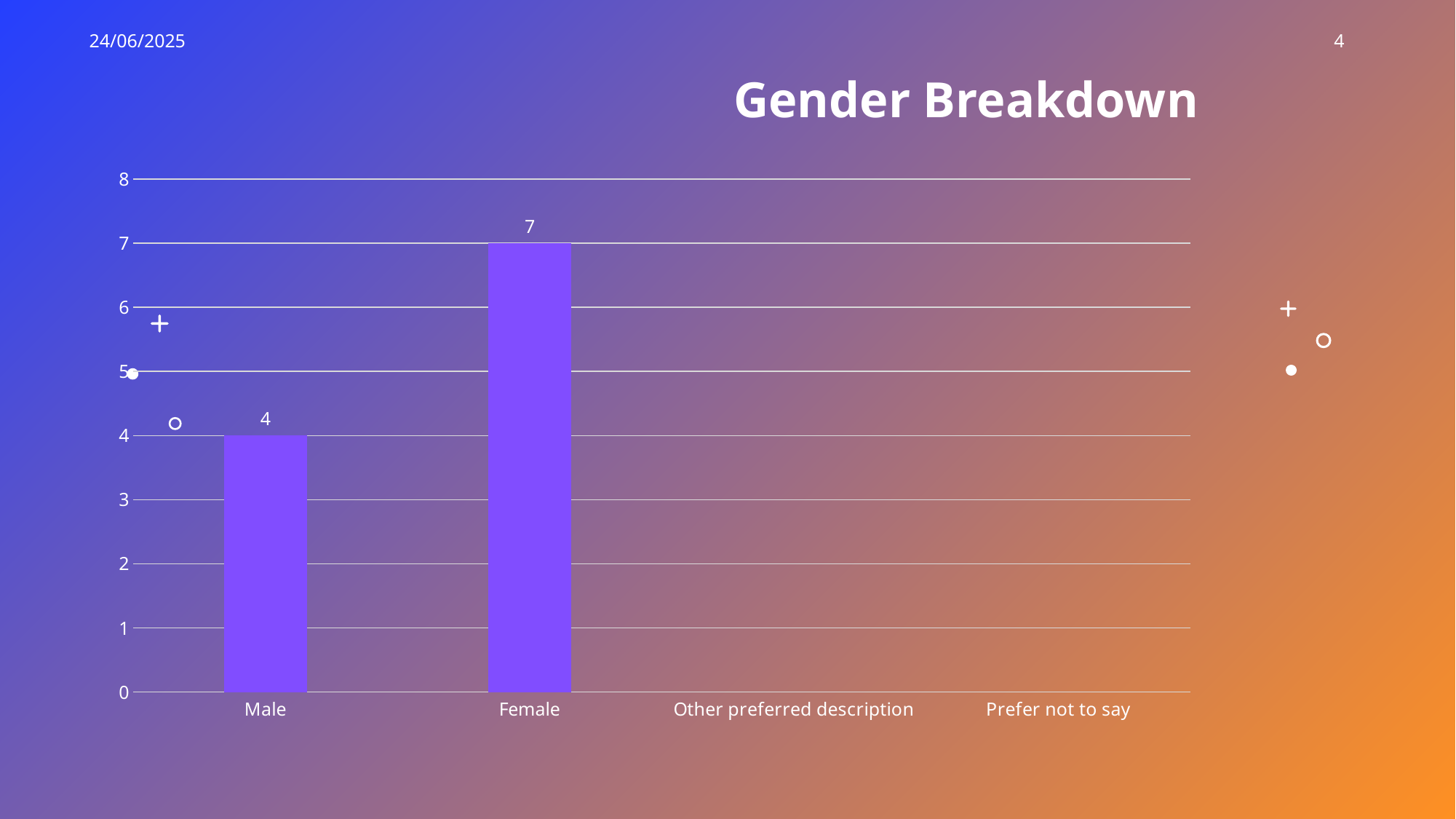
What is the title of the chart? Gender Breakdown What is the difference between the Female and Male values? 3 What kind of chart is shown on the slide? bar chart What is the value for Female? 7 What is the value for Male? 4 How many categories are shown on the x axis? 4 Which category has the highest value? Female What is the highest value shown on the y axis? 8 Which is larger, the value for Male or the value for Female? Female Is the value for Female greater or less than 5? greater Is the value for Male greater or less than 6? less What is the total of the Male and Female values? 11